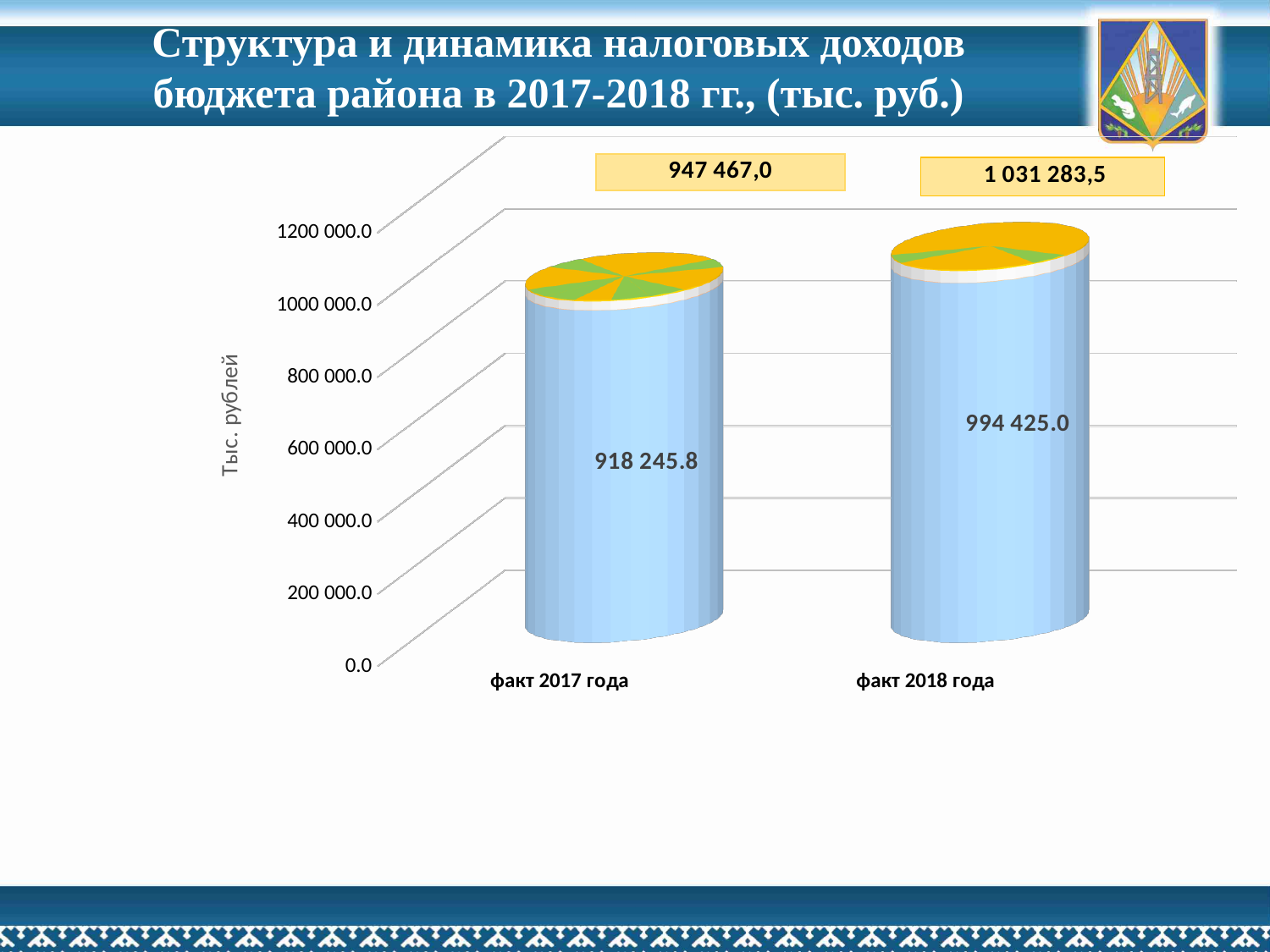
What is the difference between the blue segment values for факт 2018 года and факт 2017 года? 76 179.2 Is the value of the blue segment for факт 2017 года greater or less than 800 000.0? greater What is the value of the large blue segment for факт 2017 года? 918 245.8 How many categories are shown on the x axis? 2 What is the value of the large blue segment for факт 2018 года? 994 425.0 Which category has the higher value for the blue segment, факт 2017 года or факт 2018 года? факт 2018 года What kind of chart is shown on the slide? bar chart What is the difference between the totals shown above the bars for 2018 and 2017? 83 816,5 Which category has the lowest total? факт 2017 года What is the label of the vertical axis? Тыс. рублей What total is shown in the box above the bar for факт 2018 года? 1 031 283,5 What total is shown in the box above the bar for факт 2017 года? 947 467,0